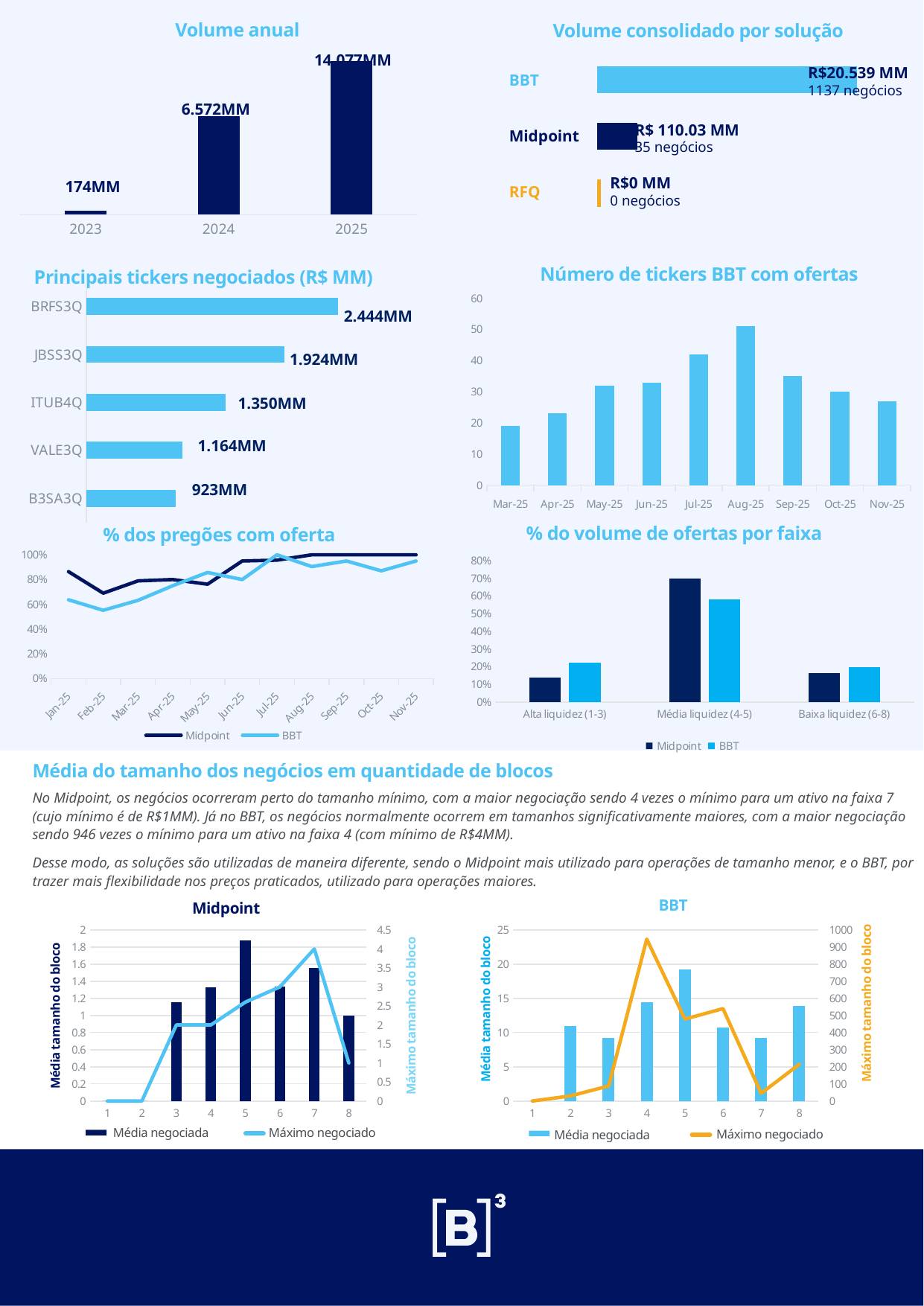
In the 'Número de tickers BBT com ofertas' chart, which month has the highest bar? Aug-25 In the 'Principais tickers negociados (R$ MM)' chart, which ticker has the highest value? BRFS3Q In the '% do volume de ofertas por faixa' chart, which series has the larger value for Média liquidez (4-5), Midpoint or BBT? Midpoint In the 'Volume anual' chart, which year has the lowest volume? 2023 In the 'Número de tickers BBT com ofertas' chart, is the value for Jul-25 greater or less than 40? greater In the 'Volume consolidado por solução' chart, how many negócios are shown for BBT? 1137 negócios In the 'Número de tickers BBT com ofertas' chart, how many months are shown on the x axis? 9 In the 'Principais tickers negociados (R$ MM)' chart, what is the value for ITUB4Q? 1.350MM In the 'Principais tickers negociados (R$ MM)' chart, how many tickers are shown? 5 What kind of chart is '% dos pregões com oferta'? Line chart In the 'Volume anual' chart, what is the value for 2024? 6.572MM In the 'Volume consolidado por solução' chart, what is the volume for Midpoint? R$ 110.03 MM